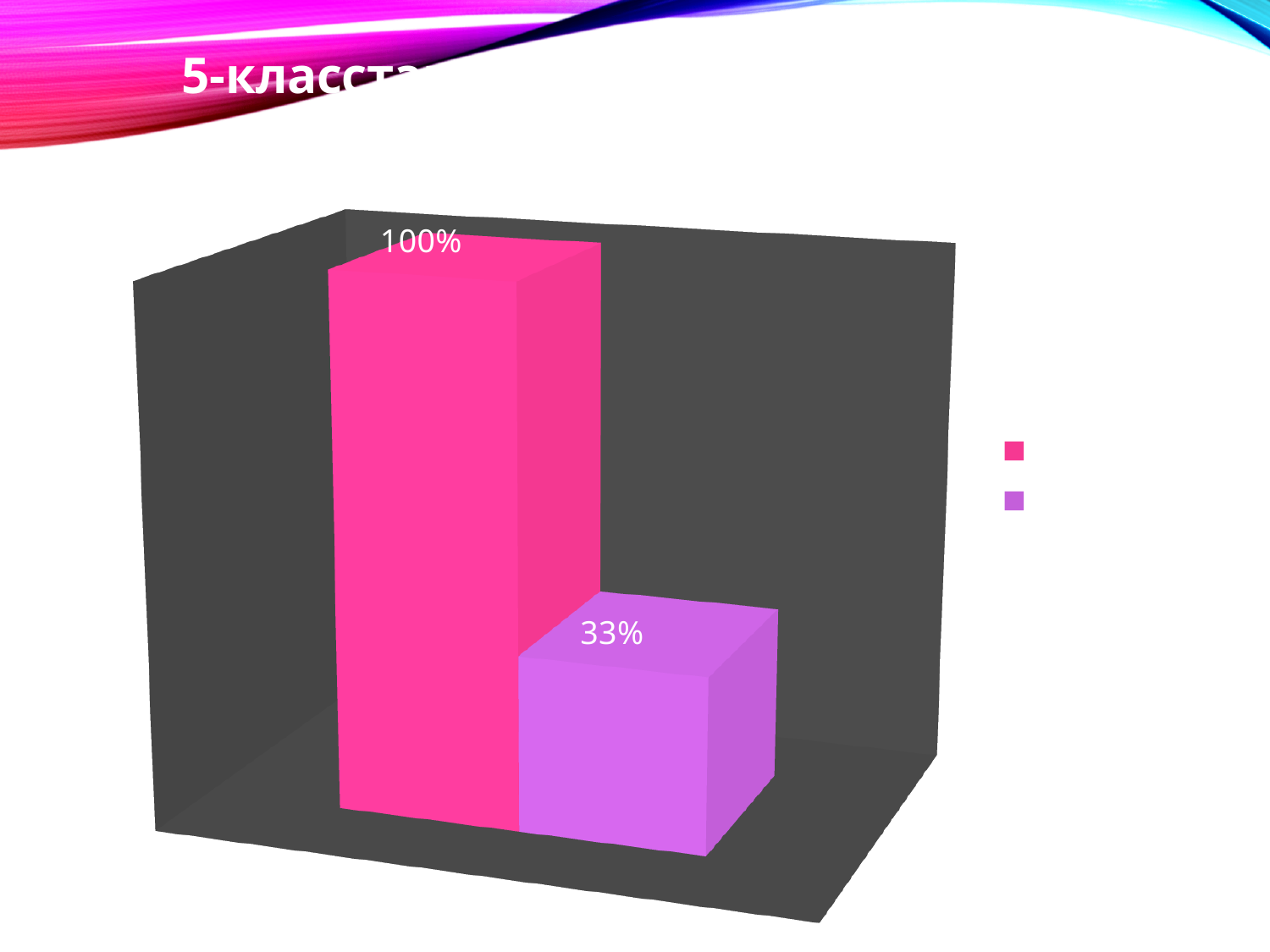
What kind of chart is shown on the slide? bar chart What is the difference between the pink bar's value and the purple bar's value? 67% How many entries does the legend show? 2 How many bars are plotted in the chart? 2 What value is shown on the pink bar? 100% Which bar has the highest value, the pink one or the purple one? the pink bar What value is shown on the purple bar? 33% What colour is the bar labelled 100%? pink What colour is the bar labelled 33%? purple Which bar has the lowest value, the pink one or the purple one? the purple bar Is the value of the pink bar larger or smaller than the value of the purple bar? larger